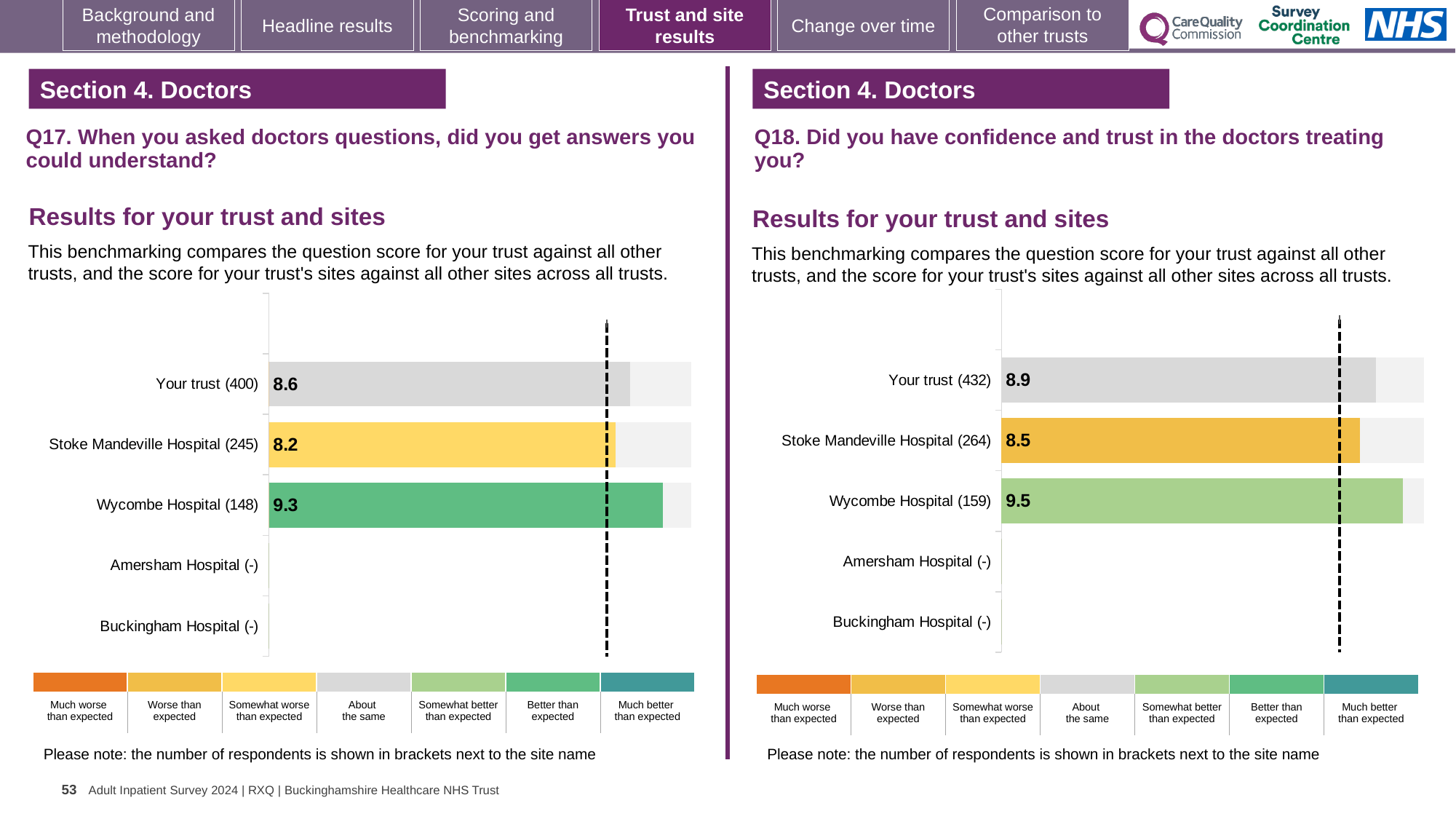
What kind of chart is the Q18 chart (right)? Bar chart On the Q17 chart (left), which benchmark category does the colour of the Wycombe Hospital bar correspond to? Better than expected On the Q17 chart (left), what is the difference between the scores for Wycombe Hospital and Stoke Mandeville Hospital? 1.1 On the Q17 chart (left), which site has the lowest score? Stoke Mandeville Hospital (245) On the Q18 chart (right), what is the score for Stoke Mandeville Hospital (264)? 8.5 On the Q17 chart (left), what is the score for Your trust (400)? 8.6 On the Q18 chart (right), which site has the highest score? Wycombe Hospital (159) How many categories are listed on the Q17 chart (left)? 5 On the Q18 chart (right), what is the score for Your trust (432)? 8.9 On the Q18 chart (right), what is the difference between the scores for Wycombe Hospital and Your trust? 0.6 On the Q18 chart (right), which is larger: the score for Your trust or the score for Stoke Mandeville Hospital? Your trust On the Q17 chart (left), what is the score for Wycombe Hospital (148)? 9.3